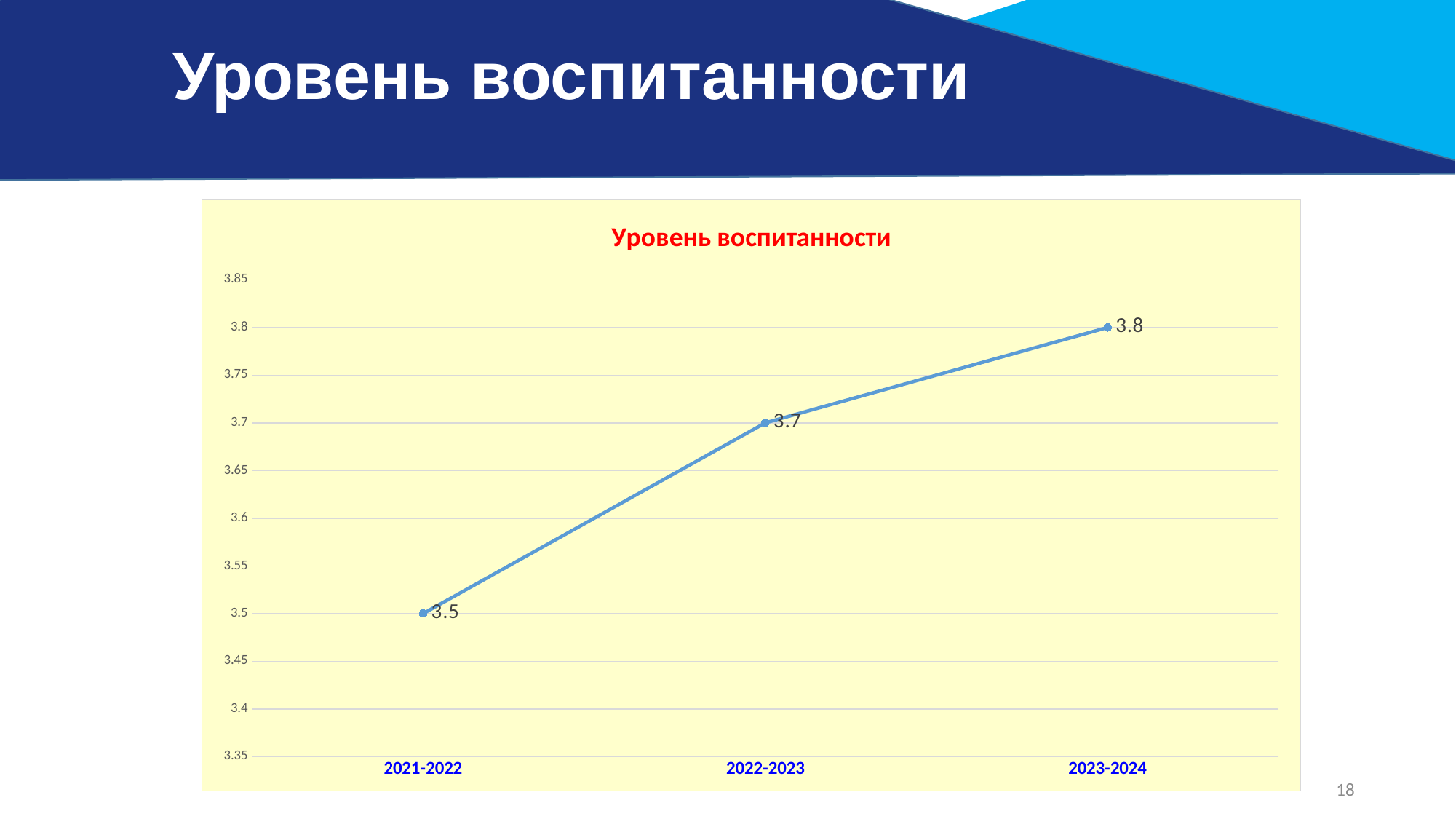
What is the value for 2022-2023? 3.7 Do the values rise or fall from 2021-2022 to 2023-2024? rise Which period has the lowest value? 2021-2022 What is the difference between the values for 2022-2023 and 2021-2022? 0.2 What is the value for 2023-2024? 3.8 Is the value for 2022-2023 greater or less than 3.6? greater Which period has the highest value? 2023-2024 What is the value for 2021-2022? 3.5 What kind of chart is shown on the slide? line chart Which is larger, the value for 2022-2023 or the value for 2023-2024? 2023-2024 How many periods are plotted on the chart? 3 What is the difference between the values for 2023-2024 and 2021-2022? 0.3